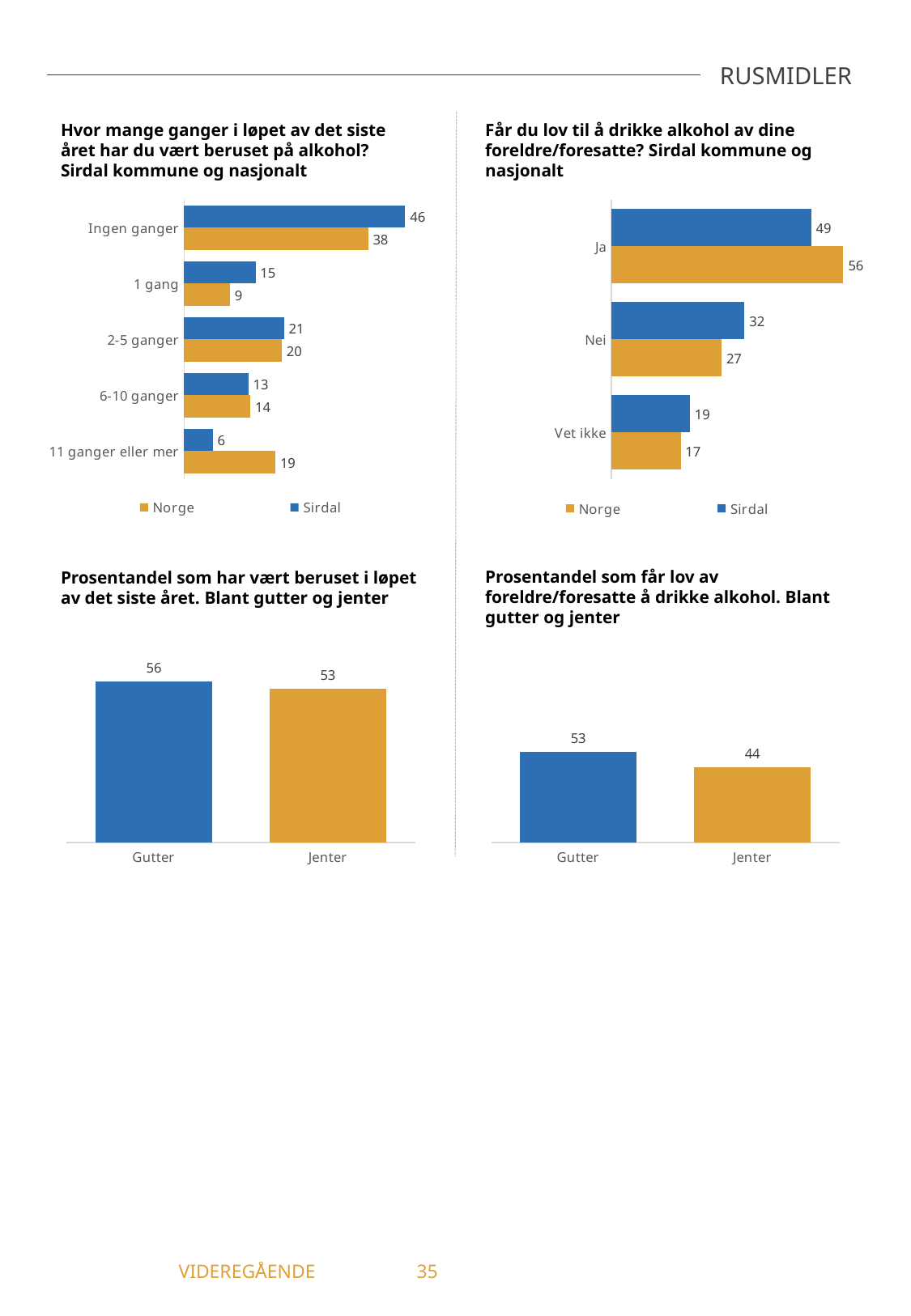
In the bottom-right chart (Prosentandel som får lov av foreldre/foresatte ...), what is the difference between Gutter and Jenter? 9 In the top-right chart (Får du lov til å drikke alkohol ...), which is larger for 'Nei': Sirdal or Norge? Sirdal In the top-left chart (Hvor mange ganger ... beruset på alkohol), how many categories are shown on the axis? 5 In the top-right chart (Får du lov til å drikke alkohol ...), what is the difference between the Sirdal and Norge values for 'Vet ikke'? 2 In the top-right chart (Får du lov til å drikke alkohol ...), what is the value for Norge in the 'Ja' category? 56 In the top-left chart (Hvor mange ganger ... beruset på alkohol), what is the value for Sirdal in the 'Ingen ganger' category? 46 In the bottom-left chart (Prosentandel som har vært beruset ...), what is the value for Gutter? 56 In the top-left chart (Hvor mange ganger ... beruset på alkohol), what is the difference between the Sirdal and Norge values for '1 gang'? 6 What type of chart is the bottom-right chart (Prosentandel som får lov av foreldre/foresatte ...)? Bar chart In the top-left chart (Hvor mange ganger ... beruset på alkohol), which category has the lowest Sirdal value? 11 ganger eller mer In the top-right chart (Får du lov til å drikke alkohol ...), how many series does the legend list? 2 In the top-left chart (Hvor mange ganger ... beruset på alkohol), what is the value for Norge in the '11 ganger eller mer' category? 19